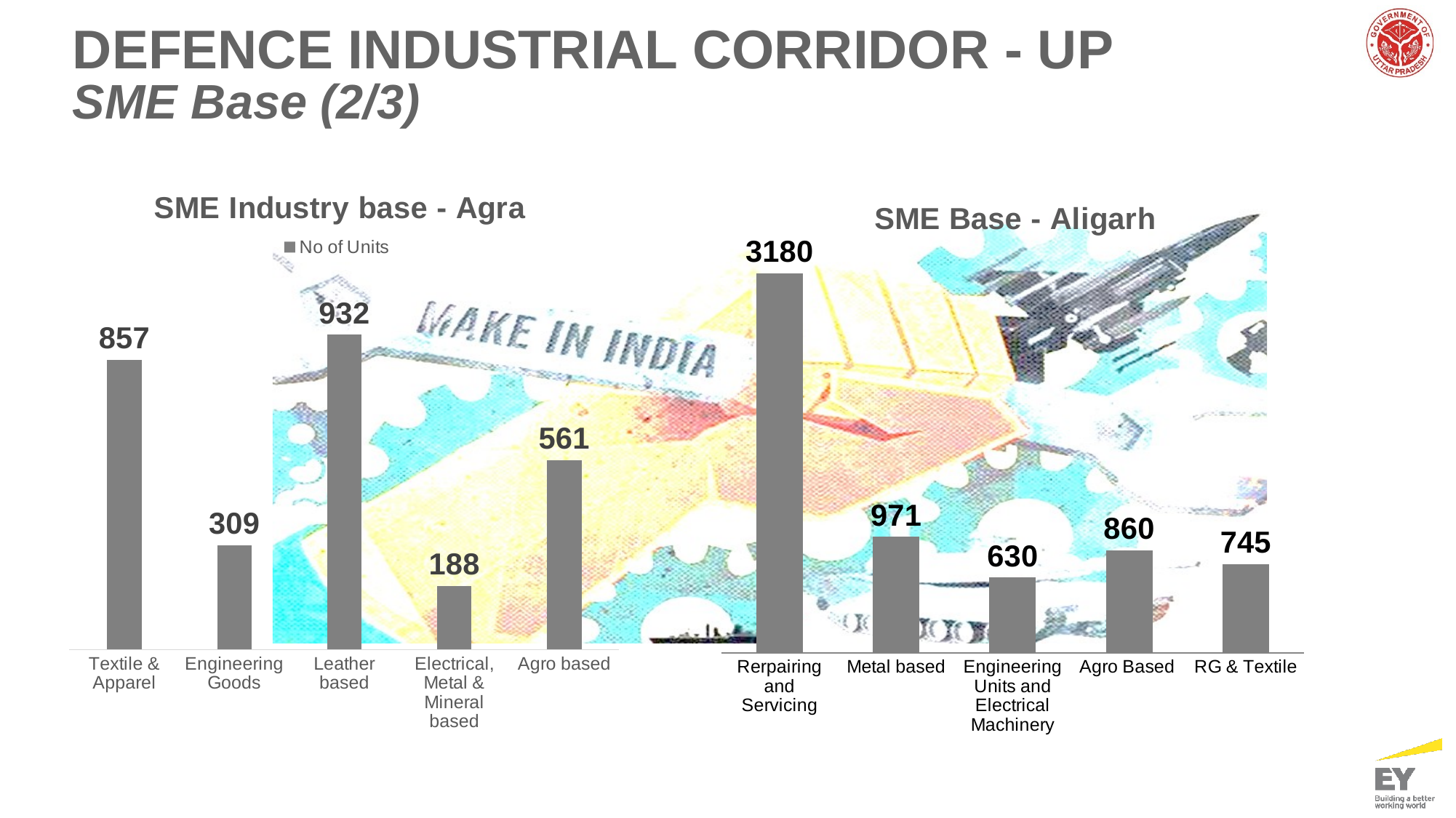
In the 'SME Industry base - Agra' chart, what is the number of units for Leather based? 932 In the 'SME Base - Aligarh' chart, which category has the lowest value? Engineering Units and Electrical Machinery In the 'SME Industry base - Agra' chart, what is the difference between Textile & Apparel and Engineering Goods? 548 In the 'SME Industry base - Agra' chart, which category has the highest number of units? Leather based In the 'SME Base - Aligarh' chart, which is larger: Metal based or Agro Based? Metal based In the 'SME Industry base - Agra' chart, what is the number of units for Electrical, Metal & Mineral based? 188 In the 'SME Industry base - Agra' chart, which category has the lowest number of units? Electrical, Metal & Mineral based What type of chart is the 'SME Industry base - Agra' chart? Bar chart In the 'SME Base - Aligarh' chart, what is the value for Rerpairing and Servicing? 3180 In the 'SME Base - Aligarh' chart, what is the difference between Rerpairing and Servicing and RG & Textile? 2435 In the 'SME Industry base - Agra' chart, how many categories are shown? 5 In the 'SME Base - Aligarh' chart, what is the value for Engineering Units and Electrical Machinery? 630